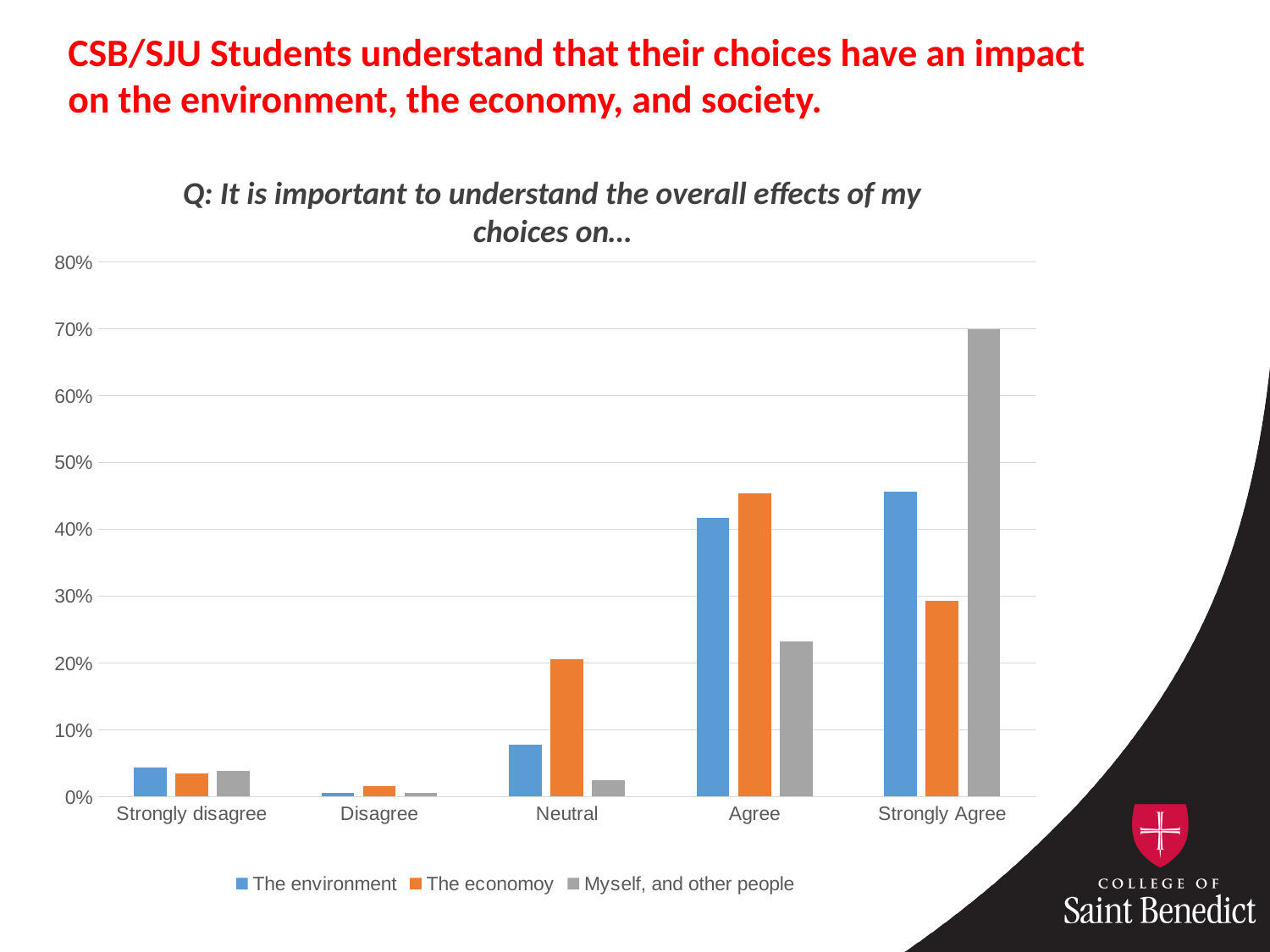
Is the value for 'The economomy' at Neutral greater or less than 10%? greater How many response categories are shown along the x axis? 5 Which series is shown in orange in the legend? The economomy Is the value for 'Myself, and other people' at Agree greater or less than 30%? less How many series does the legend list? 3 For the series 'Myself, and other people', which response category has the highest value? Strongly Agree At Strongly Agree, which series has the larger value: 'The environment' or 'The economomy'? The environment Is the value for 'Myself, and other people' at Strongly Agree greater or less than 60%? greater What kind of chart is shown on the slide? Bar chart For the series 'The economomy', which response category has the highest value? Agree At Agree, which series has the larger value: 'The environment' or 'The economomy'? The economomy For the series 'The environment', which response category has the lowest value? Disagree